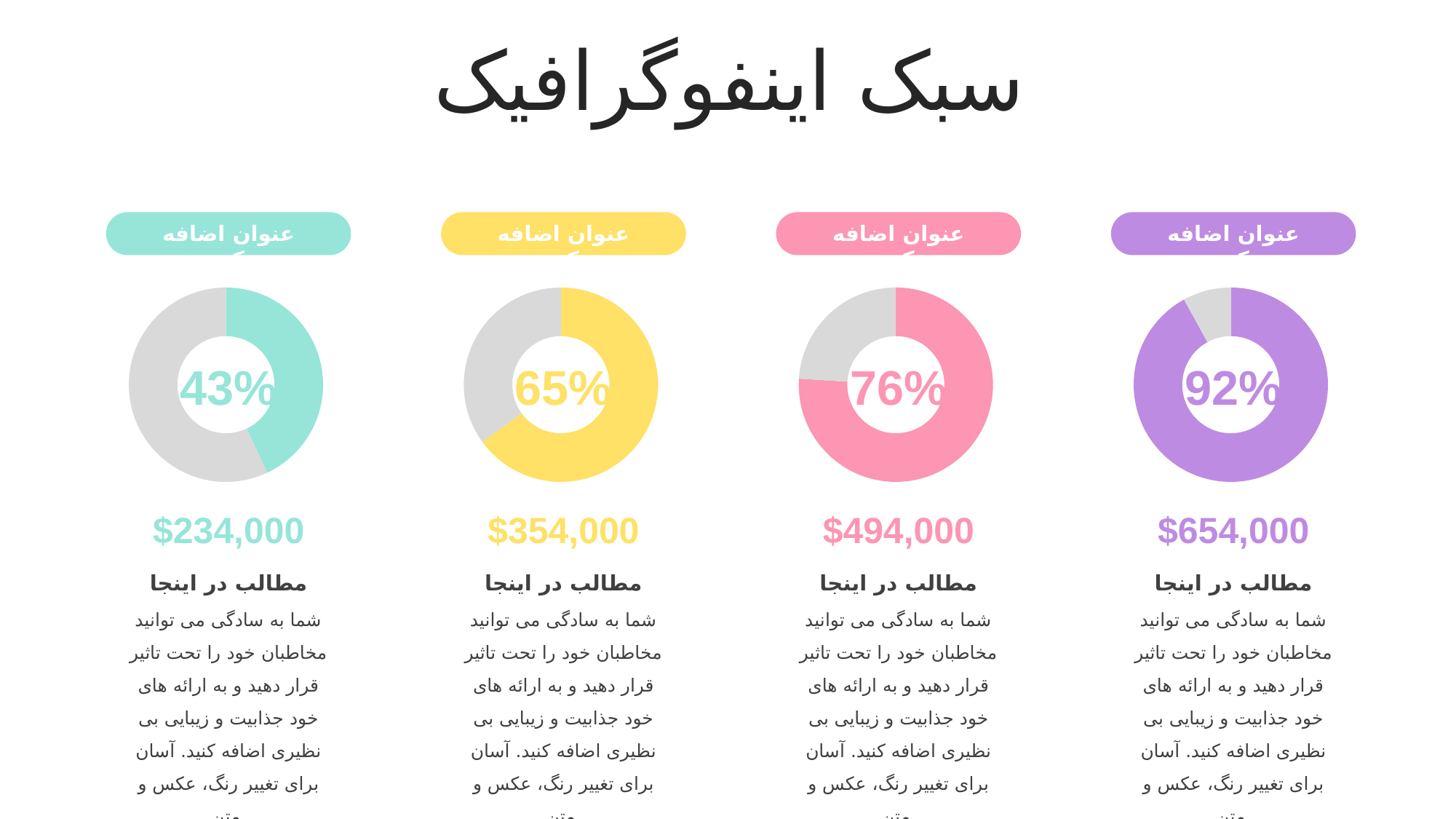
What percentage is shown in the centre of the second-from-left (yellow) donut chart? 65% What percentage is shown in the centre of the leftmost (teal) donut chart? 43% Which donut chart shows the lowest percentage? The leftmost (teal) chart, 43% What percentage is shown in the centre of the rightmost (purple) donut chart? 92% What percentage is shown in the centre of the third-from-left (pink) donut chart? 76% What dollar value is printed below the pink donut chart? $494,000 How many donut charts are on the slide? 4 Which is larger: the percentage in the yellow donut chart or the pink donut chart? The pink donut chart (76%) What kind of charts are shown on the slide? Donut charts Which donut chart shows the highest percentage? The rightmost (purple) chart, 92% Do the percentages in the donut charts rise or fall from left to right across the slide? Rise What is the difference between the percentage in the rightmost (purple) donut chart and the leftmost (teal) donut chart? 49%